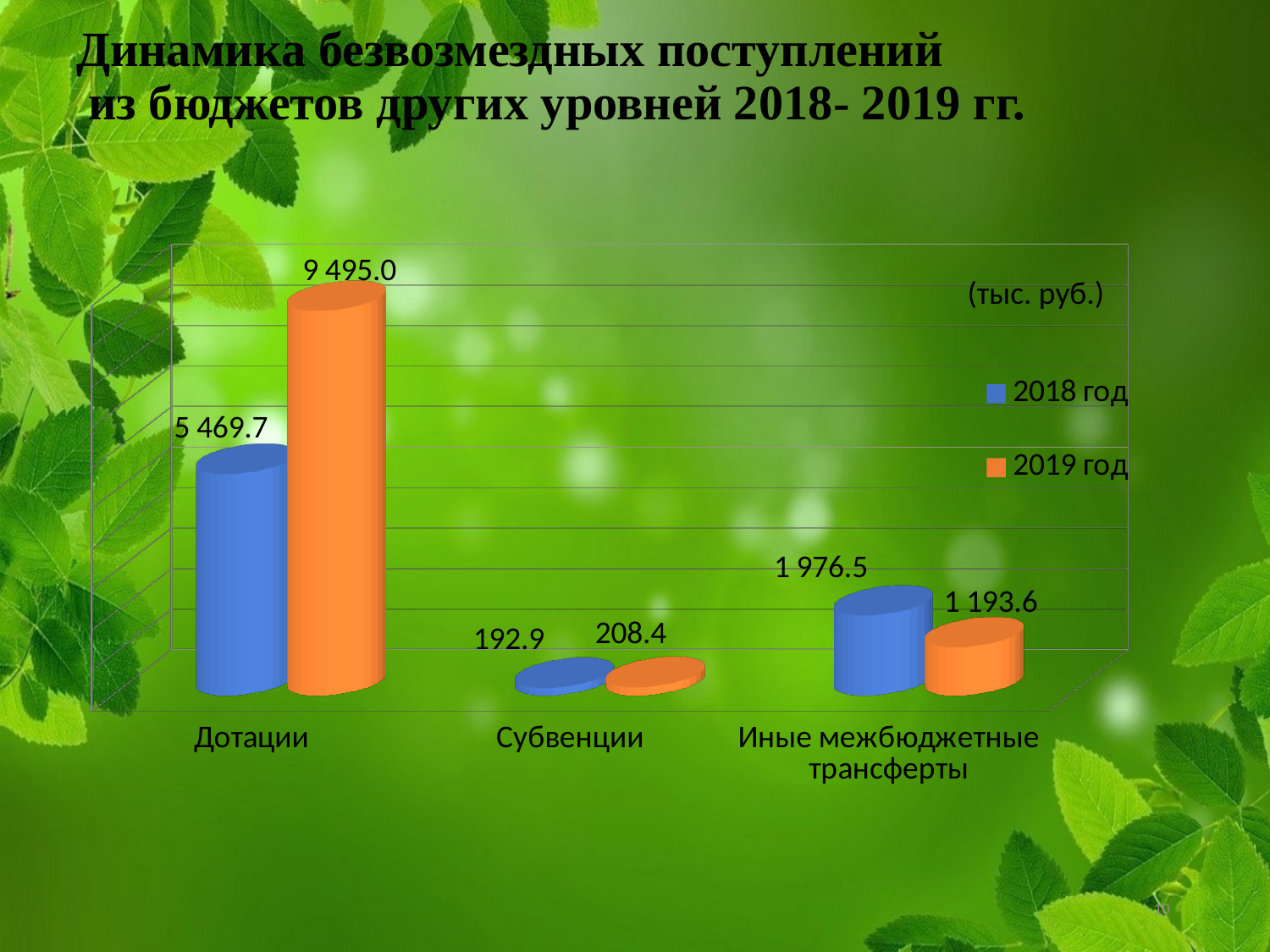
Which category has the lowest value in the 2018 год series? Субвенции How many categories are shown on the x axis? 3 How many series does the legend list? 2 What is the value for Иные межбюджетные трансферты in 2018 год? 1 976.5 What is the value for Дотации in 2019 год? 9 495.0 What kind of chart is shown on the slide? Bar chart What is the value for Субвенции in 2019 год? 208.4 Which category has the highest value in the 2019 год series? Дотации What is the difference between the 2018 год and 2019 год values for Иные межбюджетные трансферты? 782.9 What is the difference between the 2019 год and 2018 год values for Дотации? 4 025.3 For Иные межбюджетные трансферты, which year has the larger value, 2018 год or 2019 год? 2018 год What is the value for Дотации in 2018 год? 5 469.7